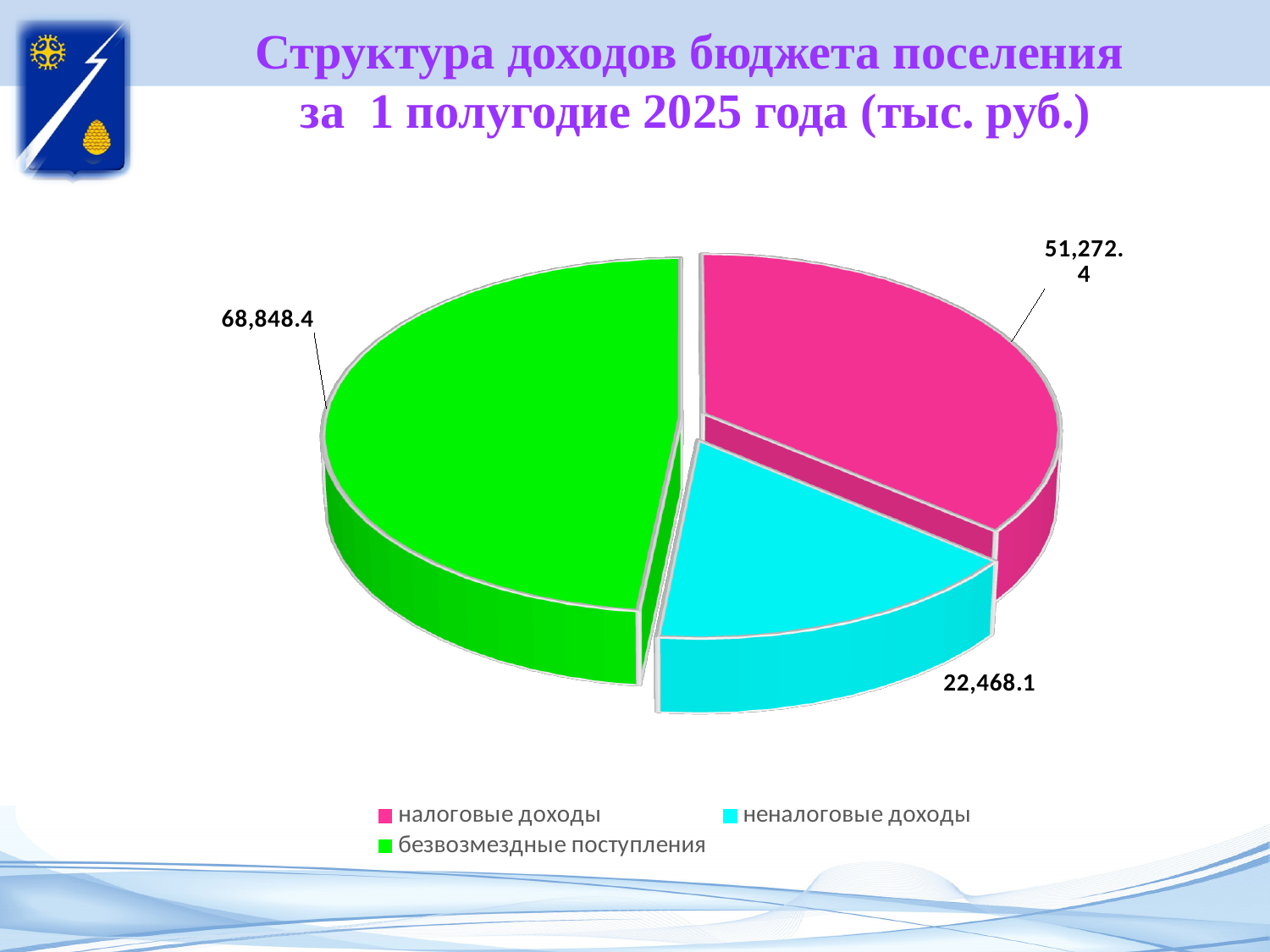
What colour is the slice for неналоговые доходы? cyan What kind of chart is shown on the slide? pie chart How many categories does the pie chart show? 3 What is the total of all three slices of the pie? 142,588.9 What is the difference between безвозмездные поступления and налоговые доходы? 17,576.0 Which category has the smallest slice of the pie? неналоговые доходы What value is shown for безвозмездные поступления? 68,848.4 Which is larger, налоговые доходы or неналоговые доходы? налоговые доходы Which category has the largest slice of the pie? безвозмездные поступления What value is shown for налоговые доходы? 51,272.4 What is the difference between налоговые доходы and неналоговые доходы? 28,804.3 What value is shown for неналоговые доходы? 22,468.1